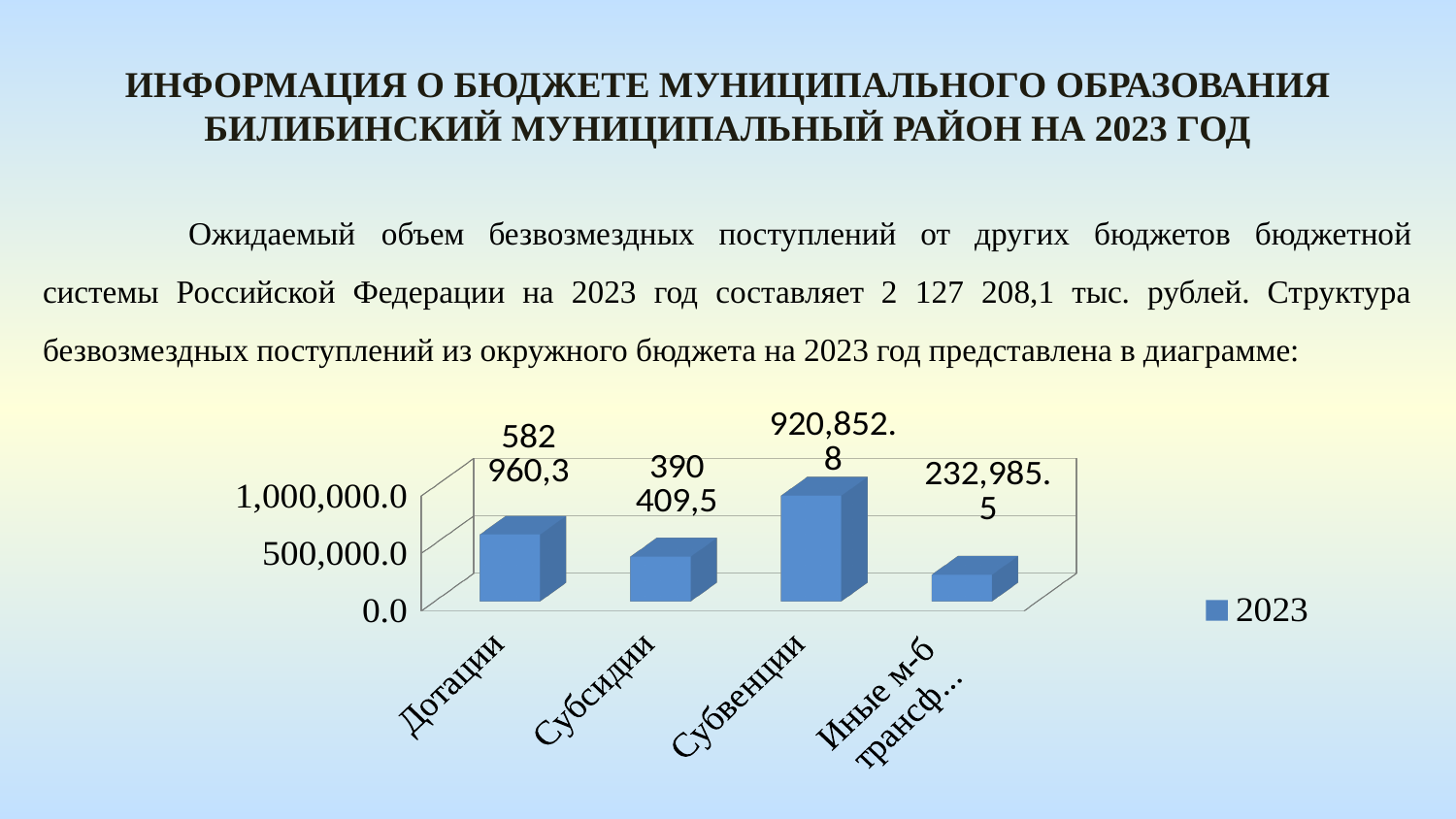
What type of chart is shown on the slide? Bar chart Which category has the highest value? Субвенции What is the difference between the value for Субвенции and the value for Иные м-б трансф...? 687,867.3 What is the value for the fourth category (Иные м-б трансф...)? 232,985.5 What entry does the chart legend list? 2023 Is the value for Субсидии greater or less than 500,000.0? less How many categories are shown on the x axis of the chart? 4 Which is larger, the value for Дотации or the value for Субсидии? Дотации Which category has the lowest value? Иные м-б трансф... What is the value for Субсидии? 390 409,5 What is the value for Дотации? 582 960,3 What is the value for Субвенции? 920,852.8